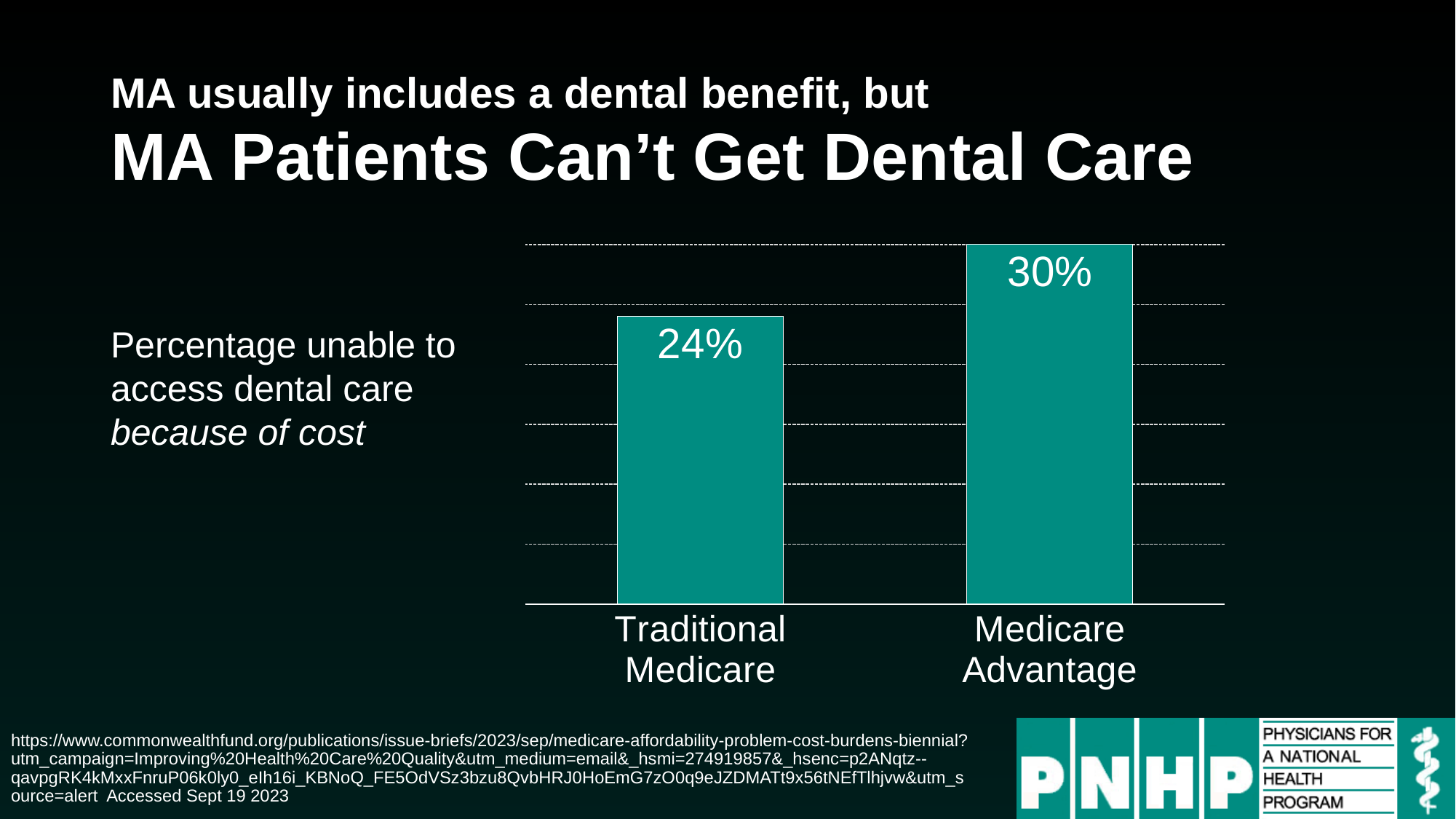
What colour are the bars in the chart? Teal Which is larger, the value for Traditional Medicare or for Medicare Advantage? Medicare Advantage What kind of chart is shown on the slide? Bar chart What is the value for Traditional Medicare? 24% What is the value for Medicare Advantage? 30% What does the chart measure, according to the text on the slide? Percentage unable to access dental care because of cost Do the values rise or fall from Traditional Medicare to Medicare Advantage? Rise Which category has the lowest value? Traditional Medicare How many categories are shown in the chart? 2 What is the difference between the Medicare Advantage and Traditional Medicare values? 6% Which category has the highest value? Medicare Advantage